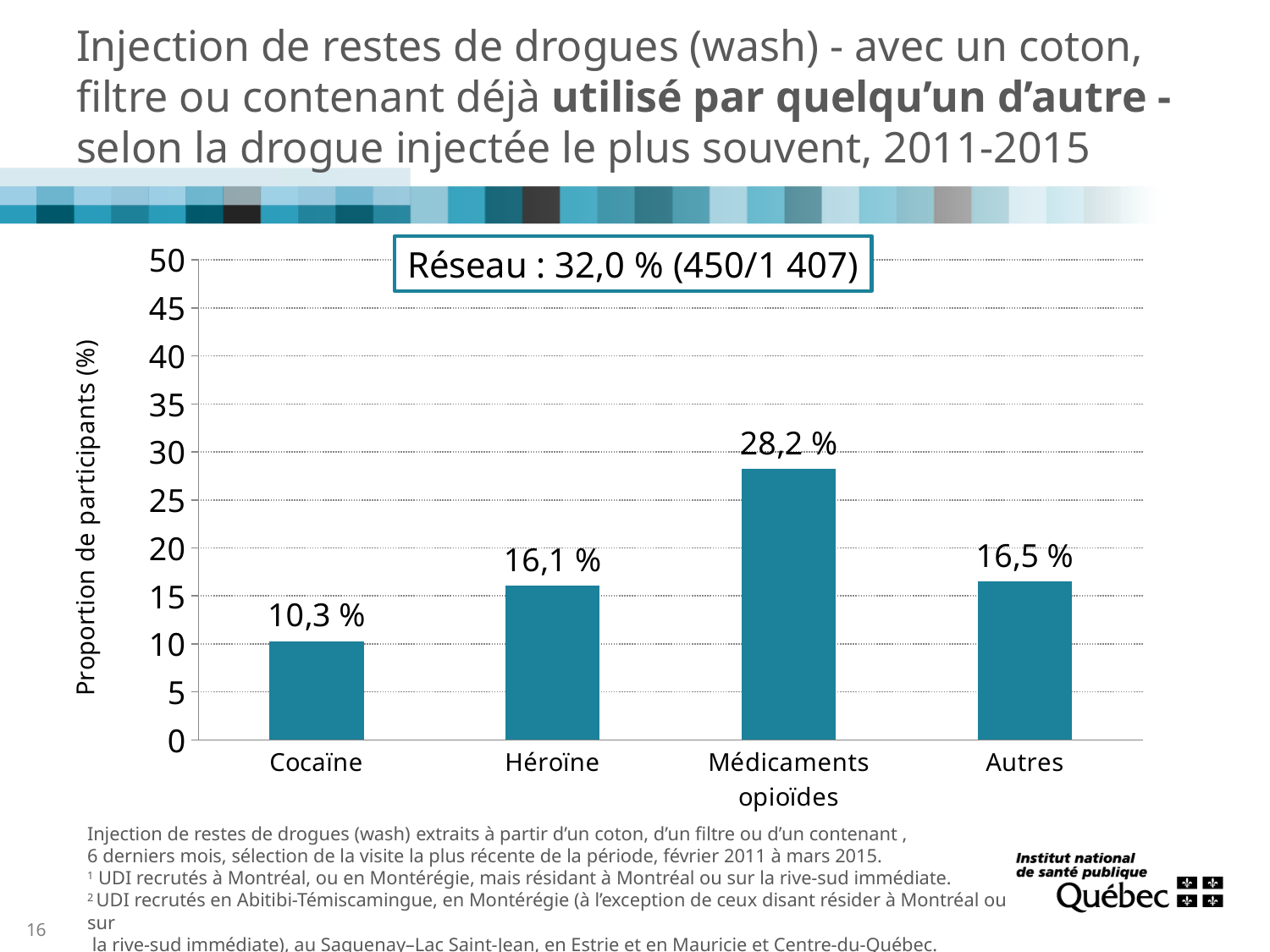
What is the value for Cocaïne? 10,3 % Which category has the lowest value? Cocaïne How many categories are shown on the x axis? 4 What is the value for Médicaments opioïdes? 28,2 % Which category has the highest value? Médicaments opioïdes What kind of chart is shown on the slide? bar chart What is the value for Héroïne? 16,1 % What value is given for Réseau in the box above the chart? 32,0 % (450/1 407) Is the value for Médicaments opioïdes greater or less than 25? greater What is the value for Autres? 16,5 % Which is larger, the value for Médicaments opioïdes or the value for Héroïne? Médicaments opioïdes What is the difference between the values for Médicaments opioïdes and Cocaïne? 17,9 %